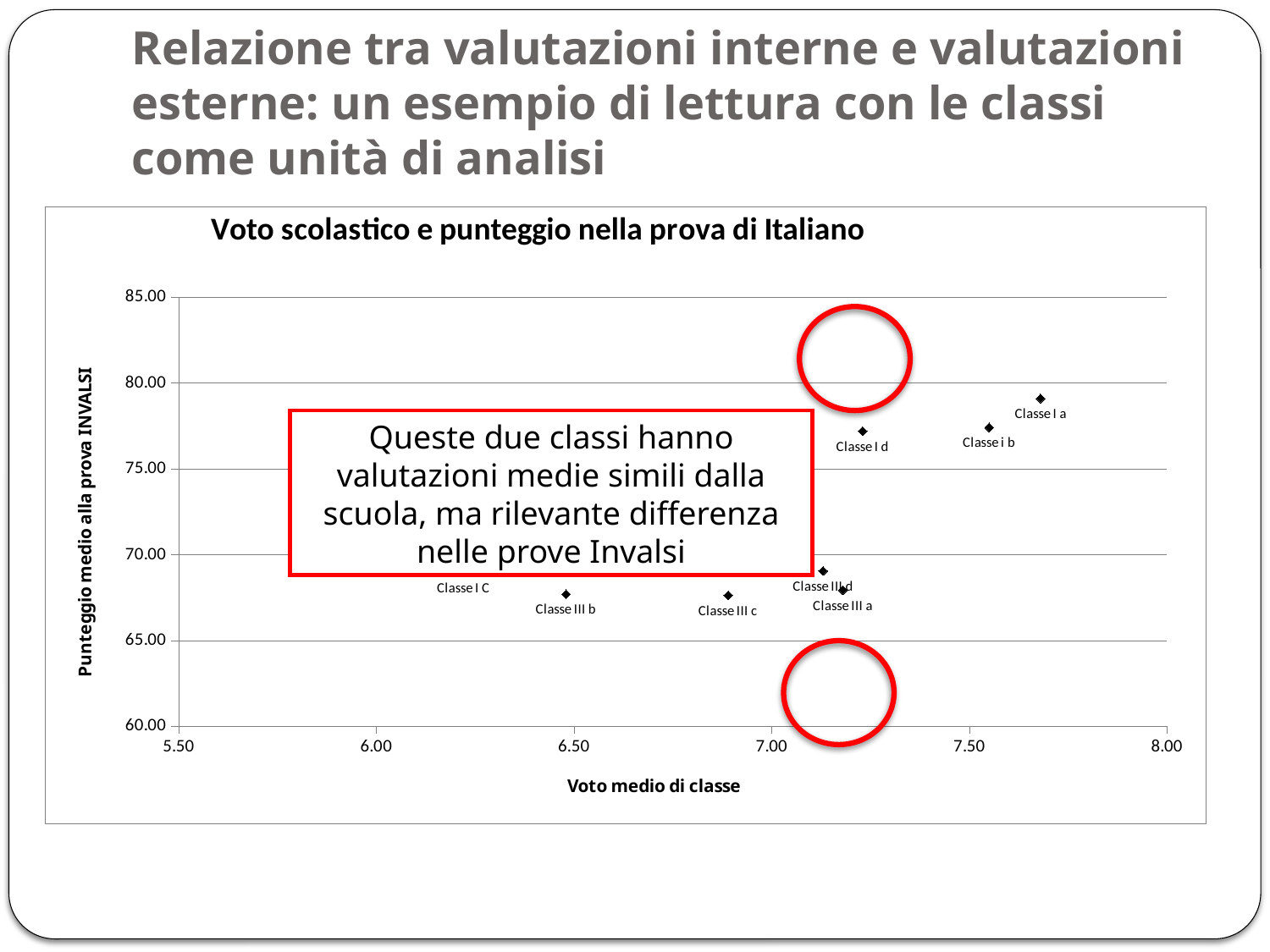
Which has the higher Punteggio medio alla prova INVALSI, Classe I a or Classe III c? Classe I a What kind of chart is shown on the slide? Scatter chart Is the Punteggio medio alla prova INVALSI for Classe III b greater or less than 70.00? less Is the Voto medio di classe for Classe III b greater or less than 7.00? less Is the Punteggio medio alla prova INVALSI for Classe I a greater or less than 75.00? greater How many class labels are shown on the chart? 8 What is the label of the horizontal axis of the chart? Voto medio di classe What is the title of the chart? Voto scolastico e punteggio nella prova di Italiano Which has the higher Punteggio medio alla prova INVALSI, Classe I d or Classe III a? Classe I d Which class has the highest Punteggio medio alla prova INVALSI? Classe I a